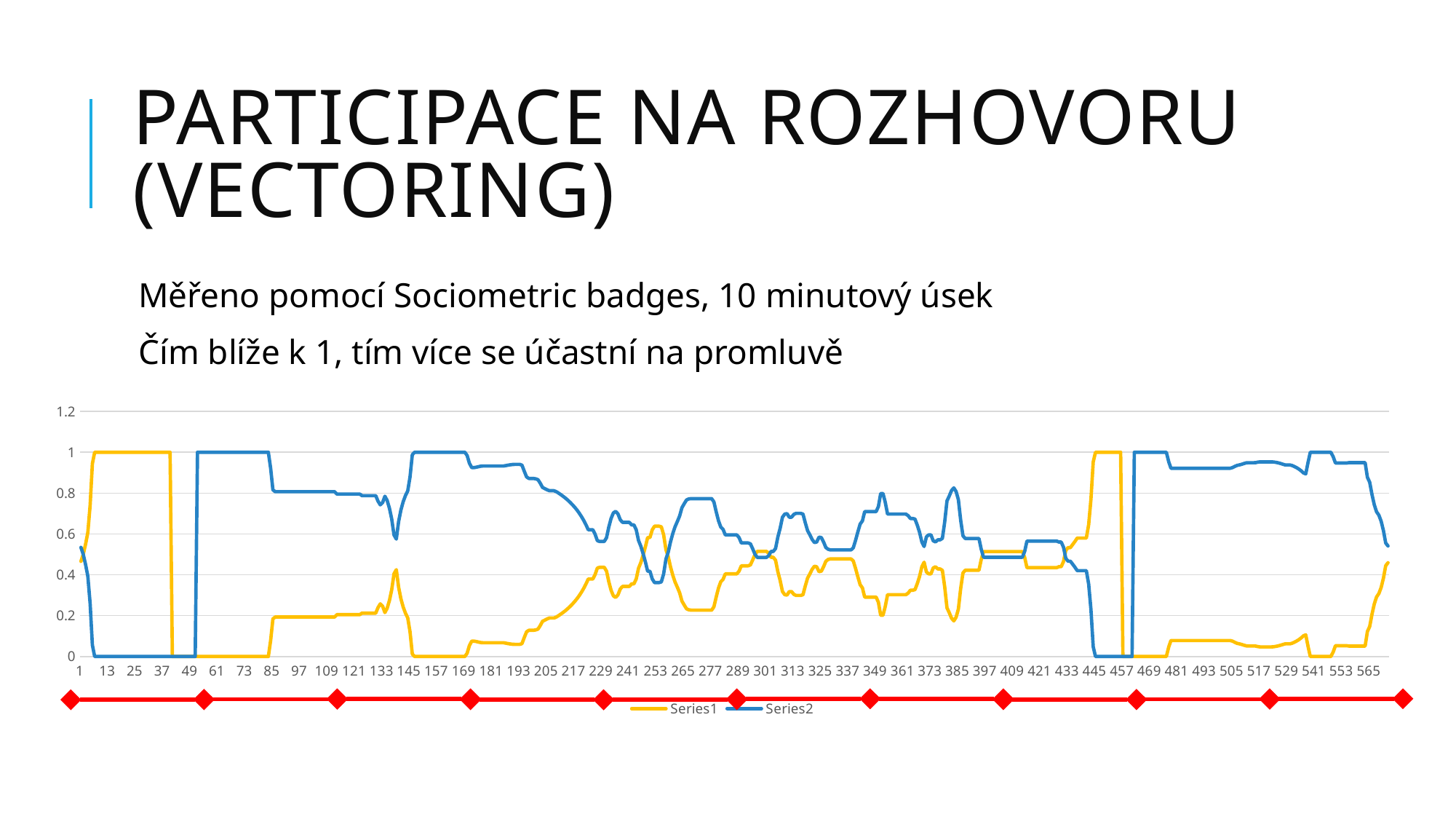
How many series does the legend list? 2 What kind of chart is shown on the slide? line chart Is the value of Series2 at x = 97 greater or less than 0.6? greater What are the names of the series in the legend? Series1 and Series2 Is the value of Series1 at x = 97 greater or less than 0.4? less At x = 61, which series has the higher value, Series1 or Series2? Series2 Is the value of Series2 at x = 205 greater or less than 0.6? greater Which colour is used for Series2? blue At x = 25, which series has the higher value, Series1 or Series2? Series1 What is the highest value shown on the vertical axis? 1.2